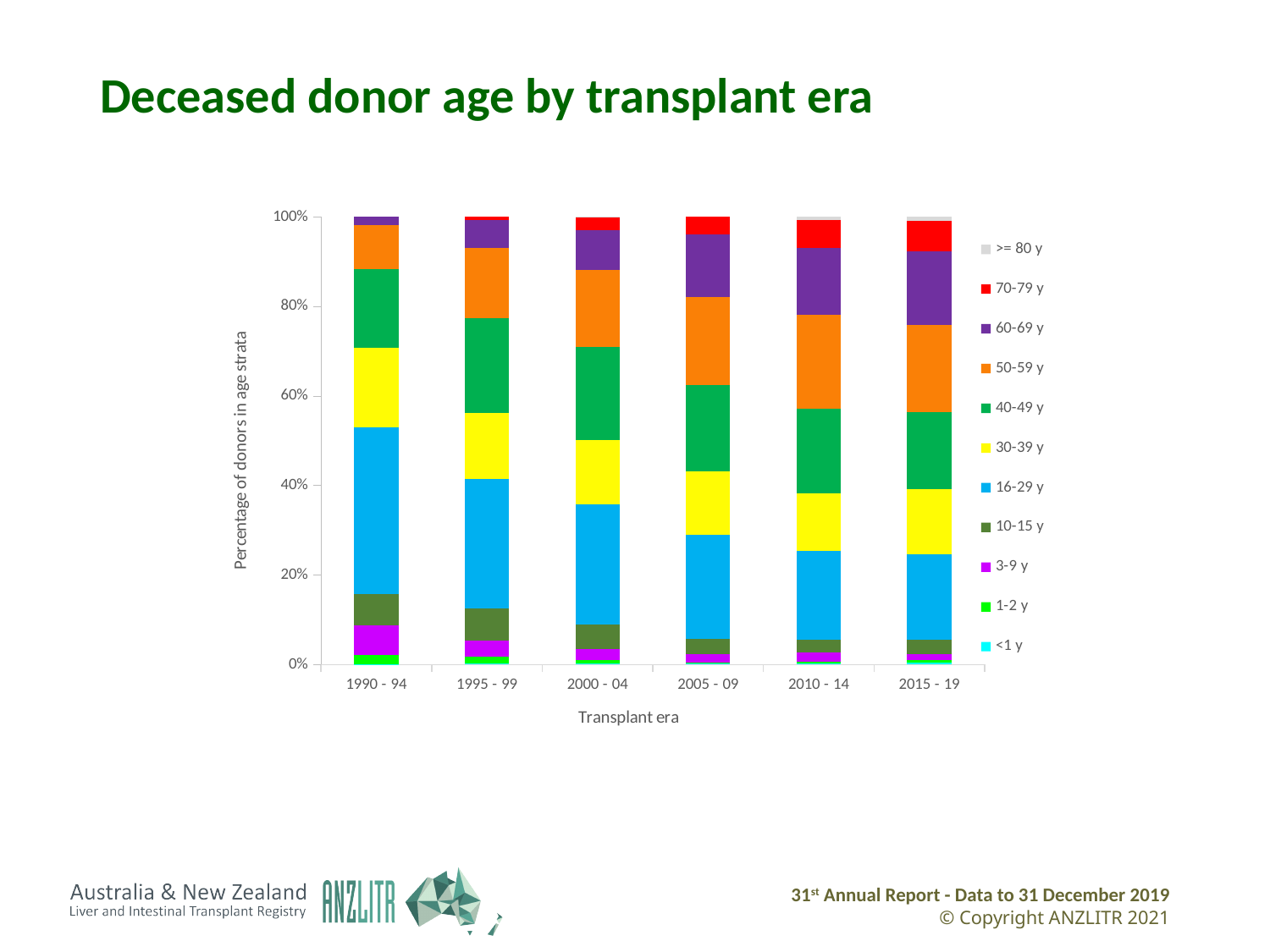
Does the share of 16-29 y donors rise or fall from 1990 - 94 to 2015 - 19? fall How many age strata does the legend list? 11 Which era has the larger 16-29 y segment, 1990 - 94 or 2015 - 19? 1990 - 94 Is the 70-79 y segment for 2015 - 19 greater or less than 20%? less Is the 16-29 y segment for 1990 - 94 greater or less than 20%? greater Is the 60-69 y segment for 1990 - 94 greater or less than 20%? less What is the label of the y axis? Percentage of donors in age strata What kind of chart is shown on the slide? Stacked bar chart Which era has the larger 60-69 y segment, 1990 - 94 or 2015 - 19? 2015 - 19 What is the title of the chart? Deceased donor age by transplant era How many transplant eras are shown along the x axis? 6 Does the share of 60-69 y donors rise or fall from 1990 - 94 to 2015 - 19? rise